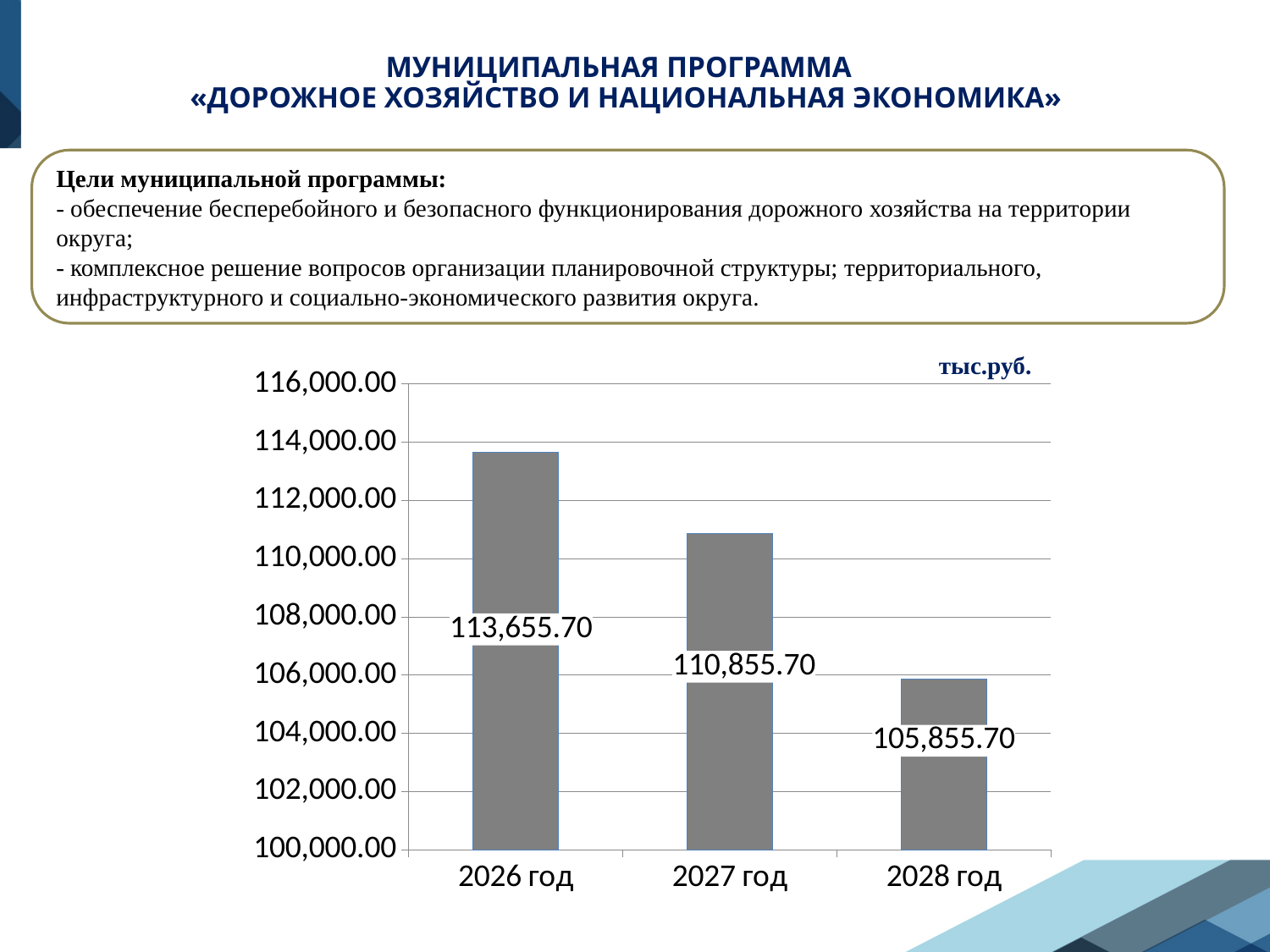
What is the difference between the values for 2026 год and 2027 год? 2,800.00 What is the difference between the values for 2026 год and 2028 год? 7,800.00 Which year has the highest value? 2026 год How many years are shown on the chart? 3 What is the value for 2026 год? 113,655.70 What is the difference between the values for 2027 год and 2028 год? 5,000.00 Which is larger, the value for 2027 год or the value for 2028 год? 2027 год Which year has the lowest value? 2028 год What is the value for 2028 год? 105,855.70 What kind of chart is shown on the slide? bar chart Is the value for 2028 год greater or less than 106,000.00? less What is the value for 2027 год? 110,855.70